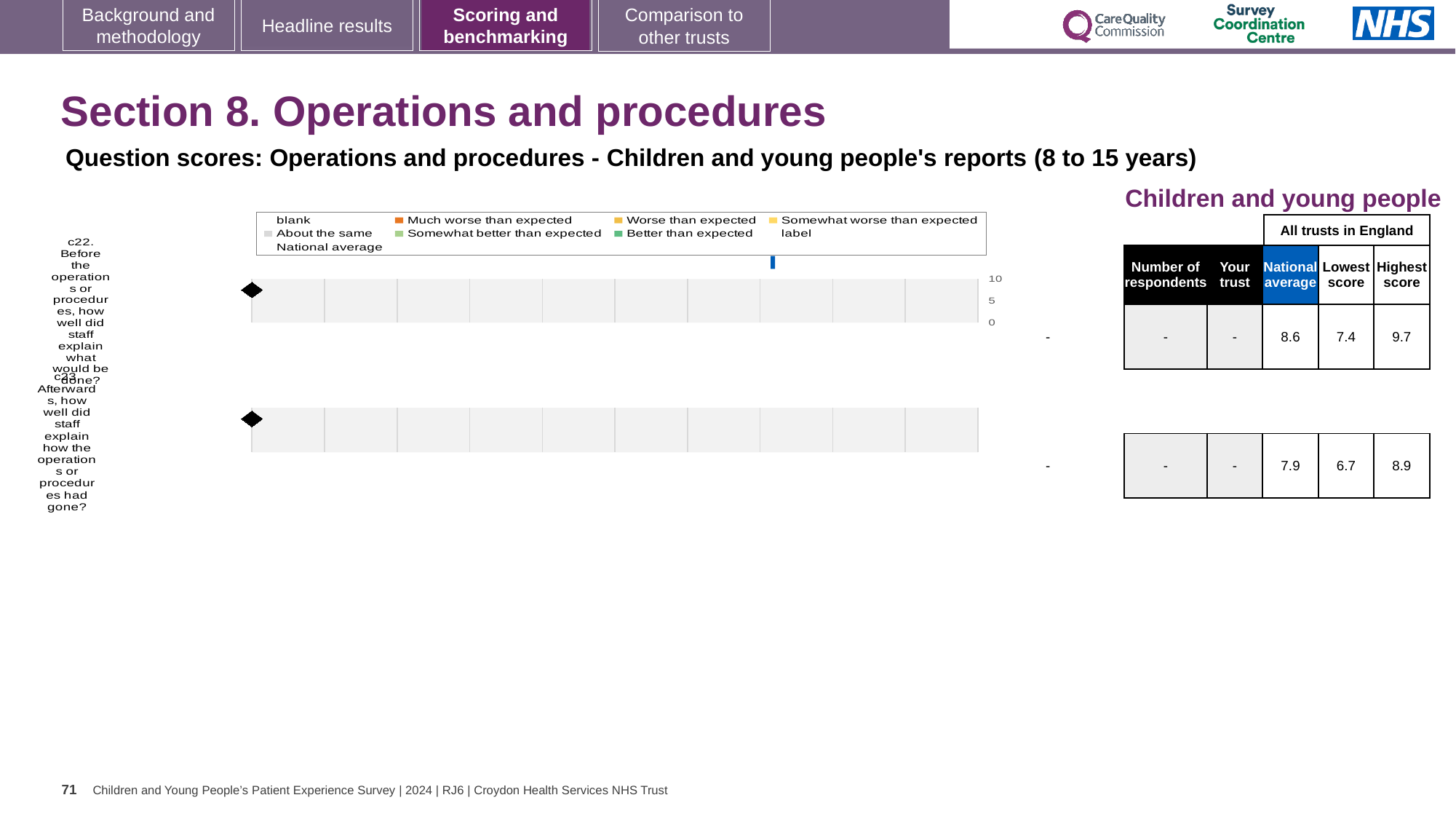
In the table next to the chart, what is the difference between the National average for c22 and c23? 0.7 What kind of chart is used on this slide? bar chart What is the highest value shown on the chart's numeric axis? 10 In the table next to the chart, what is the difference between the Highest score and Lowest score for c22? 2.3 How many question categories are shown on the chart's vertical axis? 2 In the table next to the chart, which question has the higher National average, c22 or c23? c22 In the table next to the chart, what is the Lowest score for c22? 7.4 Which legend entry is shown with an orange marker? Much worse than expected In the table next to the chart, what is the National average for c22 (Before the operations or procedures, how well did staff explain what would be done?)? 8.6 In the table next to the chart, what is the Highest score for c23 (Afterwards, how well did staff explain how the operations or procedures had gone?)? 8.9